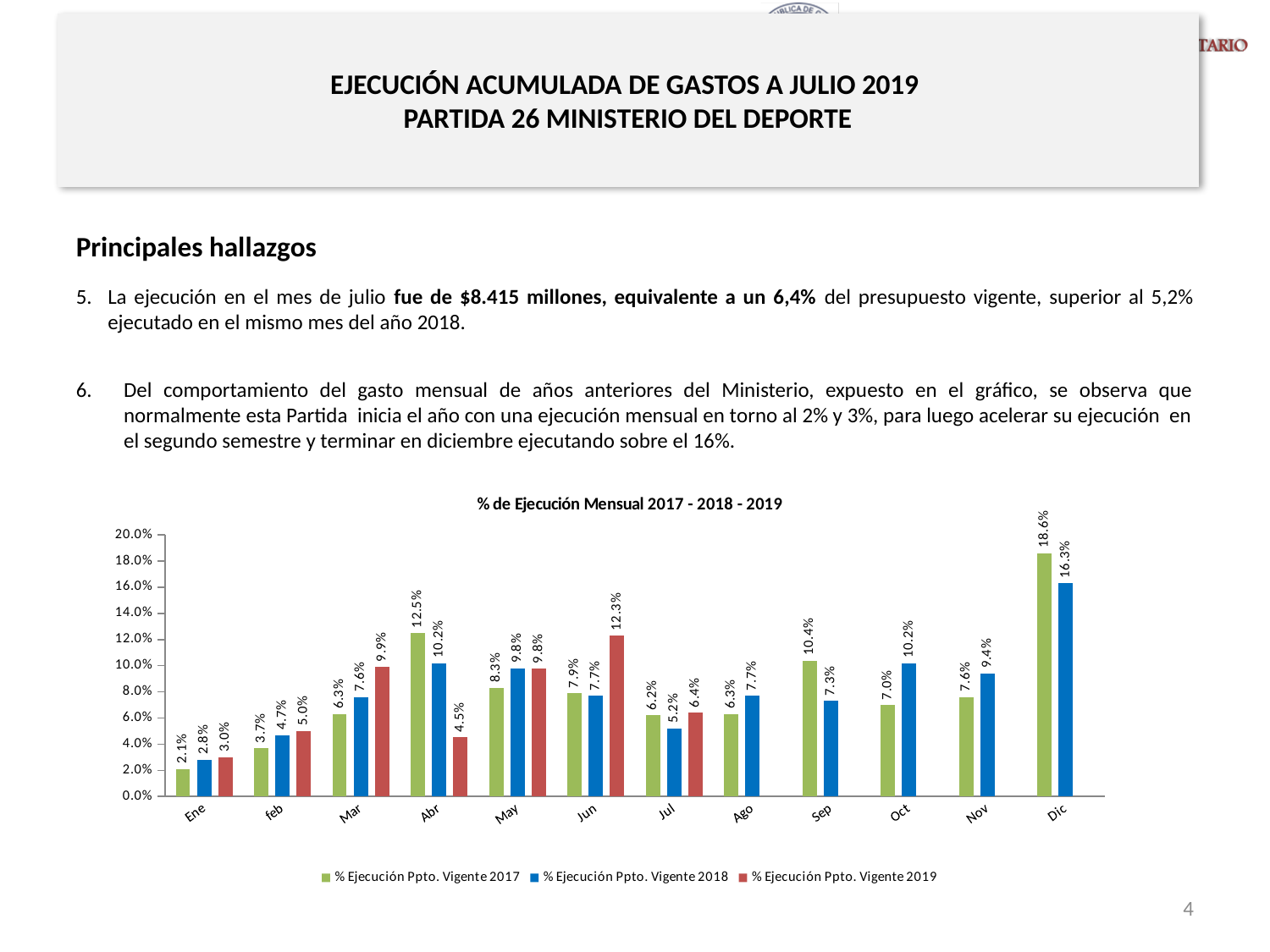
What kind of chart is shown on the slide? Bar chart Which month is the last one with a value for the 2019 series? Jul What is the title of the chart? % de Ejecución Mensual 2017 - 2018 - 2019 In which month is the % Ejecución Ppto. Vigente 2019 series highest? Jun What is the value for % Ejecución Ppto. Vigente 2017 in Dic? 18.6% In which month is the % Ejecución Ppto. Vigente 2017 series lowest? Ene What is the value for % Ejecución Ppto. Vigente 2018 in Abr? 10.2% How many series does the legend list? 3 How many months are shown on the x axis? 12 Which is larger in Abr: the 2017 value or the 2019 value? 2017 value (12.5%) What is the difference between the 2017 and 2018 values in Dic? 2.3% What is the value for % Ejecución Ppto. Vigente 2019 in Jul? 6.4%